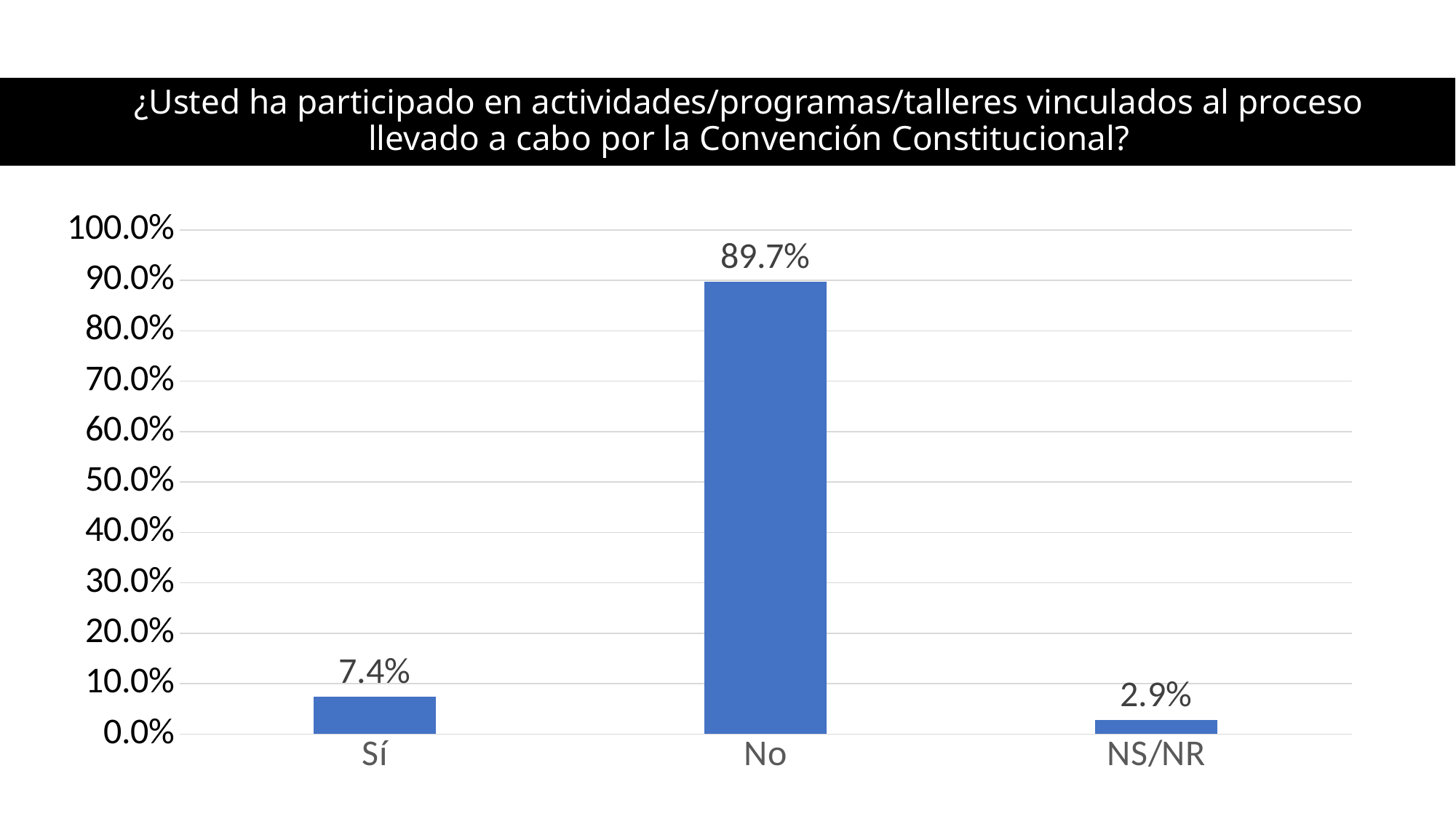
What is the value for "Sí"? 7.4% Which category has the highest value? No What is the value for "NS/NR"? 2.9% What is the difference between the values for "Sí" and "NS/NR"? 4.5% What kind of chart is shown on the slide? Bar chart Is the value for "No" greater or less than 80.0%? greater What is the difference between the values for "No" and "Sí"? 82.3% What is the value for "No"? 89.7% Which is larger, the value for "Sí" or the value for "NS/NR"? Sí Which category has the lowest value? NS/NR What is the highest tick value shown on the y axis? 100.0% How many categories are shown on the x axis? 3